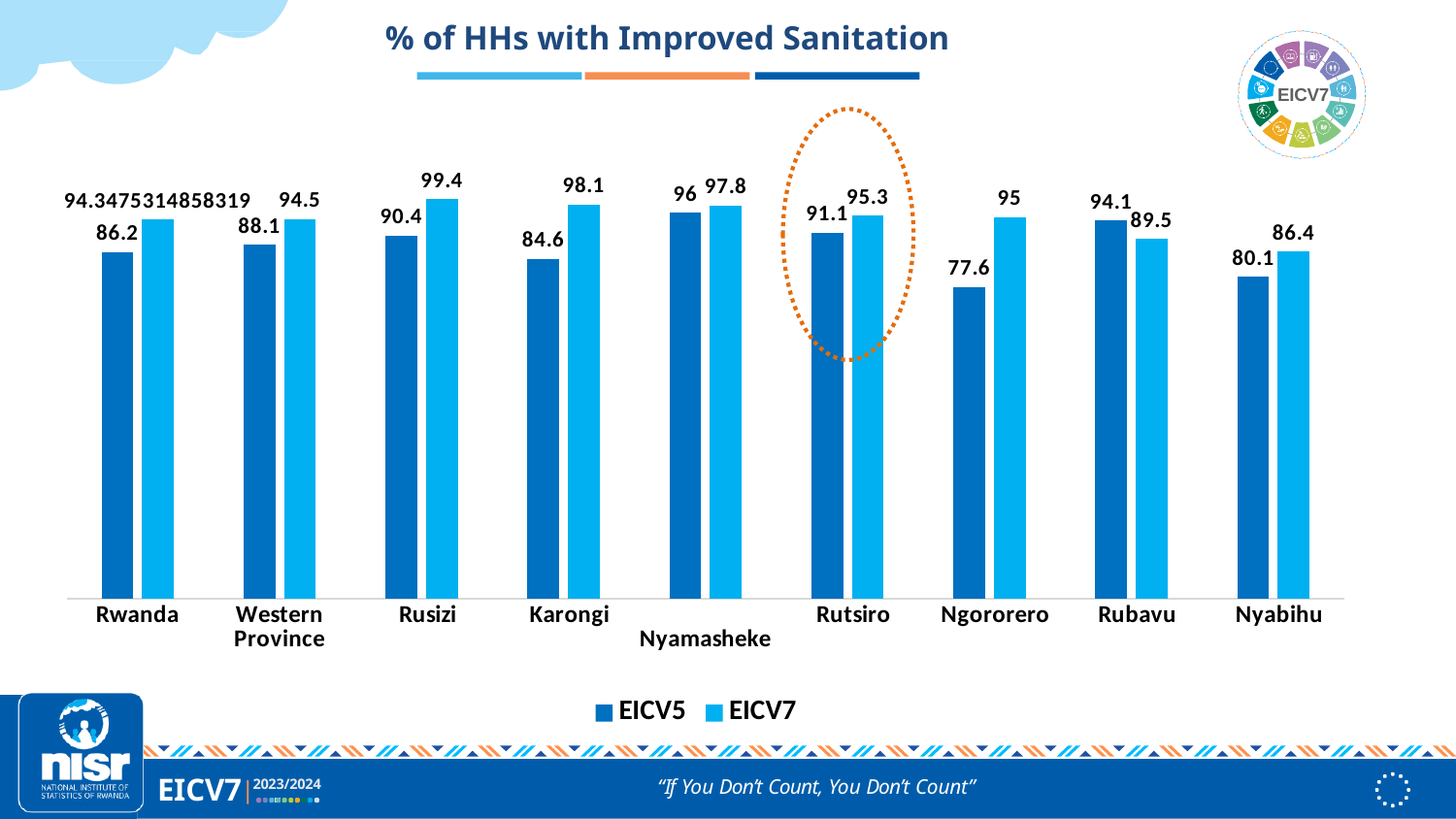
What is the EICV7 value for Nyabihu? 86.4 Which category has the lowest EICV5 value? Ngororero What is the EICV7 value for Rusizi? 99.4 What is the EICV5 value for Ngororero? 77.6 What is the difference between the EICV7 and EICV5 values for Ngororero? 17.4 How many categories are shown on the x axis? 9 Which district has the highest EICV7 value? Rusizi What is the EICV5 value for Karongi? 84.6 How many series does the legend list? 2 What is the difference between the EICV7 and EICV5 values for Karongi? 13.5 For Rubavu, which is larger, the EICV5 value or the EICV7 value? EICV5 What type of chart is shown on the slide? Bar chart